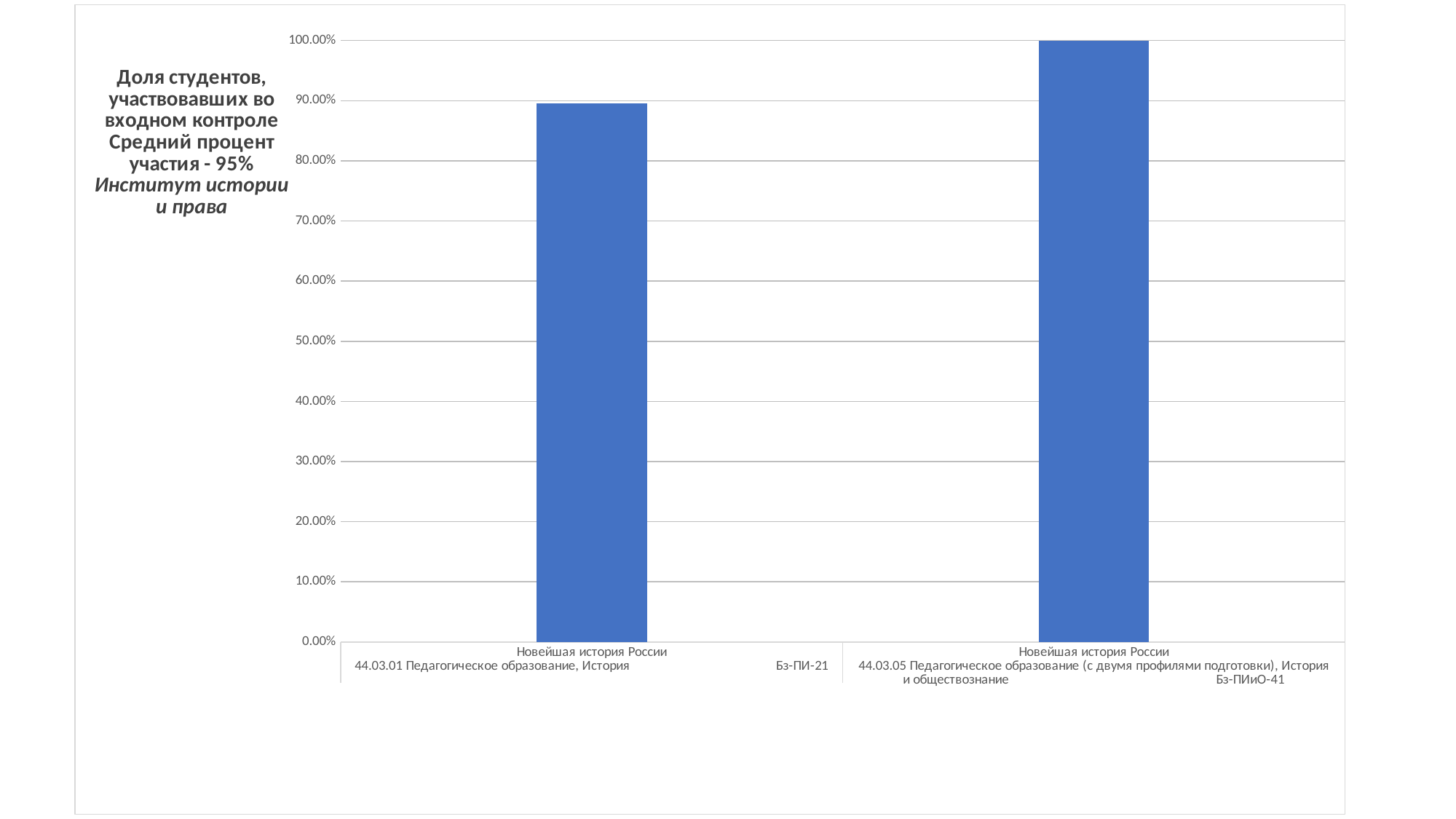
According to the chart title, what is the average participation percentage (Средний процент участия)? 95% Which group has the larger value, Бз-ПИ-21 or Бз-ПИиО-41? Бз-ПИиО-41 What kind of chart is shown on the slide? bar chart Which group has the lowest share of students who took part in the entrance control? Бз-ПИ-21 What is the value for the group Бз-ПИиО-41? 100.00% How many bars are plotted in the chart? 2 Is the value for Бз-ПИ-21 greater or less than 100.00%? less What is the maximum value shown on the vertical axis? 100.00% Is the value for Бз-ПИ-21 greater or less than 80.00%? greater Which group has the highest share of students who took part in the entrance control? Бз-ПИиО-41